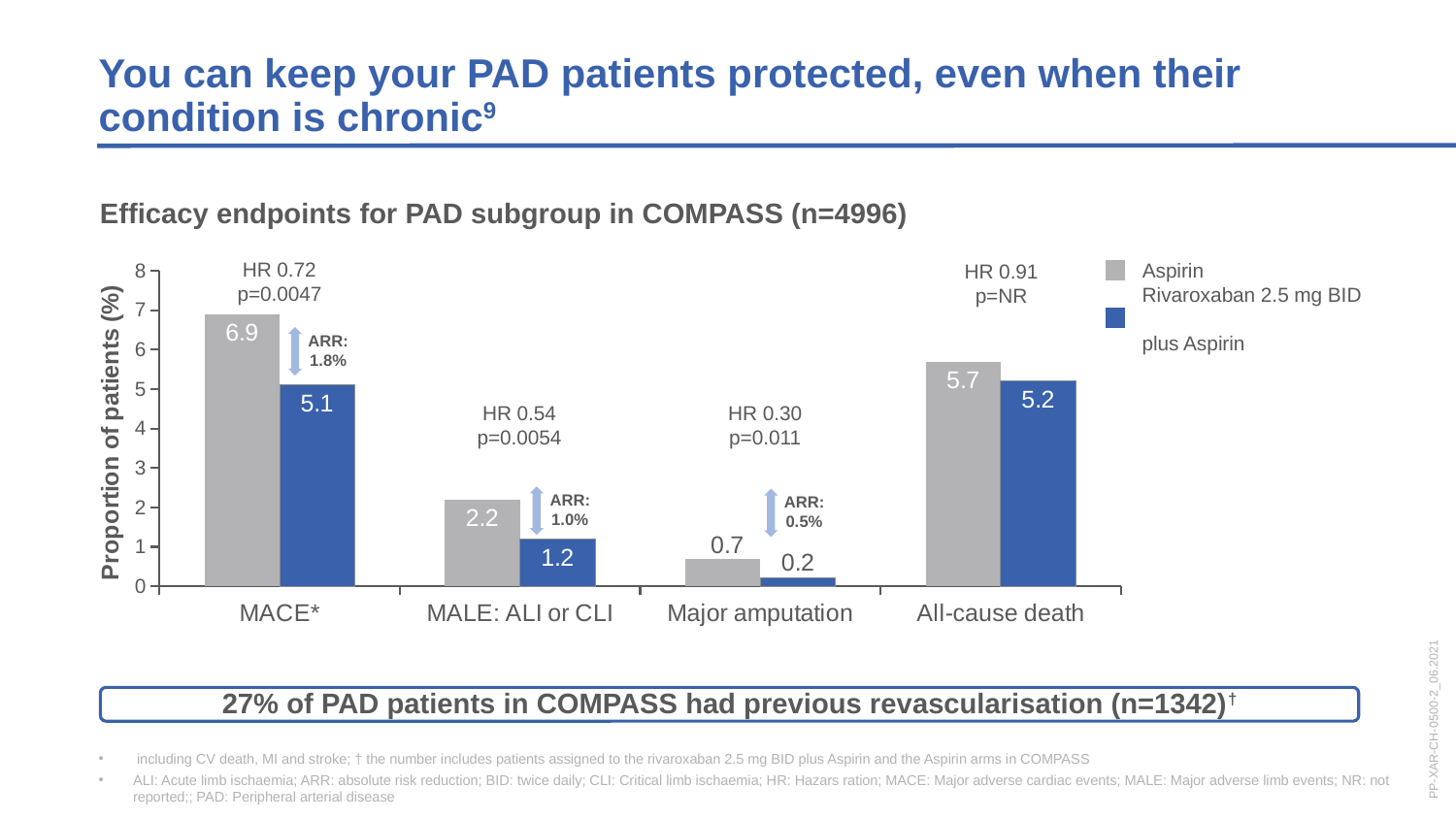
What is the difference between the Aspirin and Rivaroxaban 2.5 mg BID plus Aspirin values in the MALE: ALI or CLI category? 1.0 Which is larger: the Aspirin value for All-cause death or the Aspirin value for MALE: ALI or CLI? All-cause death Which category has the lowest value for Rivaroxaban 2.5 mg BID plus Aspirin? Major amputation What is the value for Rivaroxaban 2.5 mg BID plus Aspirin in the All-cause death category? 5.2 What is the value for Aspirin in the MACE* category? 6.9 What is the value for Rivaroxaban 2.5 mg BID plus Aspirin in the Major amputation category? 0.2 What is the label of the y axis? Proportion of patients (%) Is the Aspirin value for All-cause death greater or less than 5? greater How many series does the legend list? 2 Which category has the highest value for Aspirin? MACE* How many categories are shown on the x axis? 4 What kind of chart is shown on the slide? bar chart